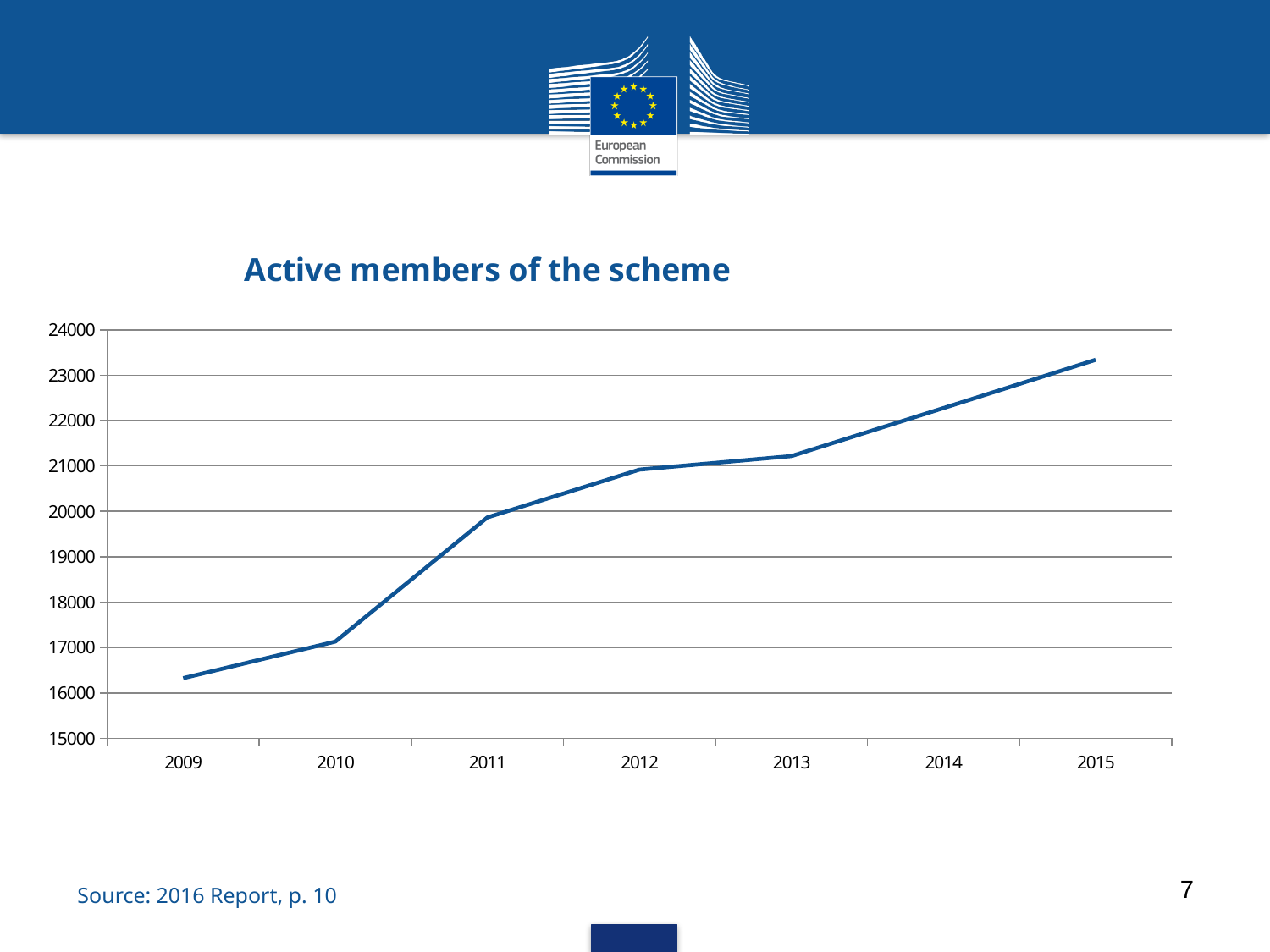
Is the value for 2009 greater or less than 17000? less Which year has more active members, 2010 or 2011? 2011 Is the value for 2014 greater or less than 22000? greater How many years are plotted on the x axis of the chart? 7 What is the title of the chart? Active members of the scheme Is the value for 2015 greater or less than 23000? greater What type of chart is shown on the slide? line chart Do the values rise or fall from 2009 to 2015? rise Which year has the highest number of active members? 2015 Which year has the lowest number of active members? 2009